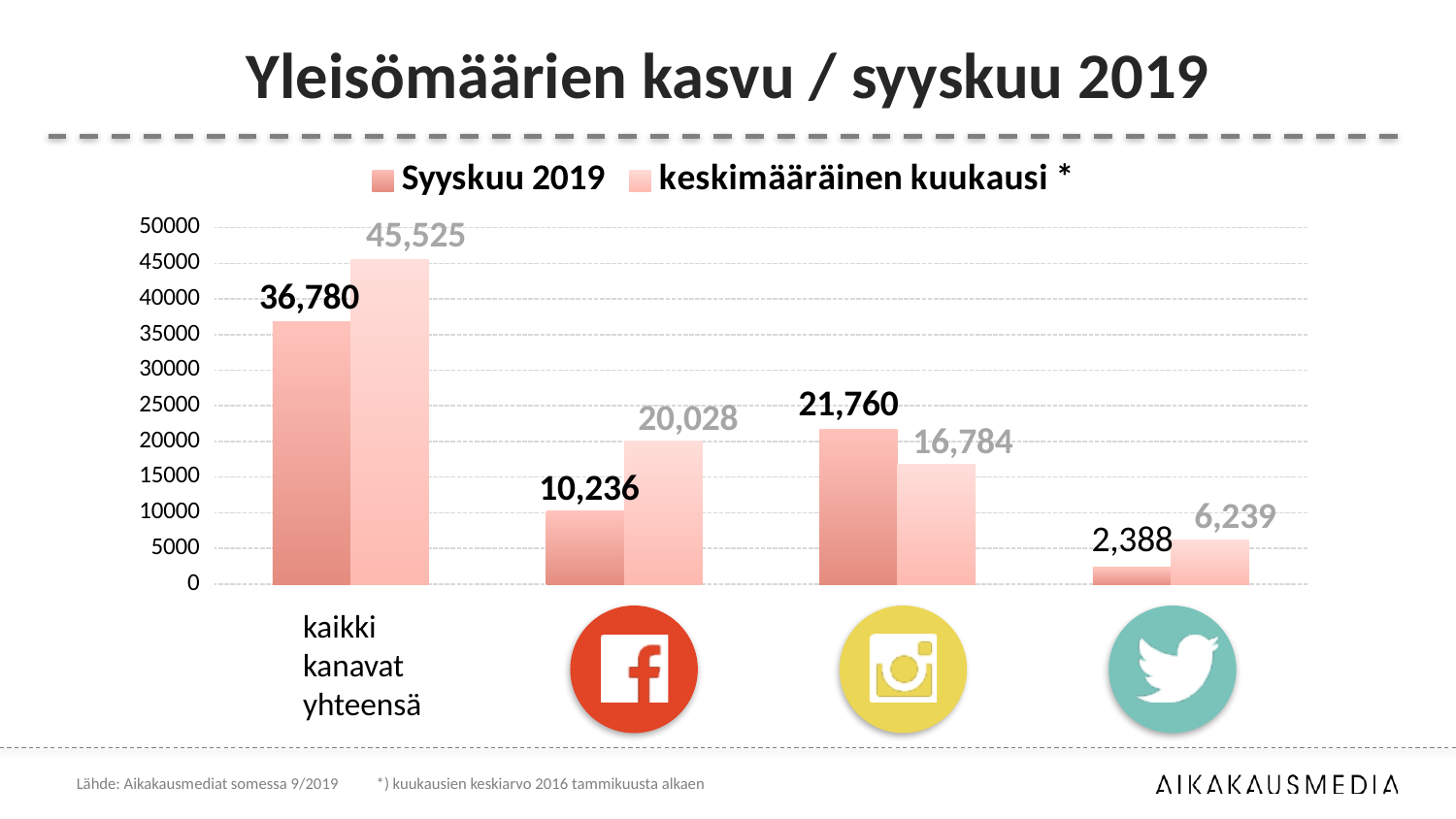
What is the Syyskuu 2019 value for the Facebook category? 10,236 How many categories are shown on the x axis? 4 Which category has the lowest Syyskuu 2019 value? Twitter How many series does the legend list? 2 What is the keskimääräinen kuukausi value for kaikki kanavat yhteensä? 45,525 What is the keskimääräinen kuukausi value for the Instagram category? 16,784 Is the keskimääräinen kuukausi value for the Twitter category greater or less than 5000? greater For the Instagram category, which is larger: the Syyskuu 2019 value or the keskimääräinen kuukausi value? Syyskuu 2019 What is the difference between the keskimääräinen kuukausi and Syyskuu 2019 values for the Facebook category? 9,792 What kind of chart is shown on the slide? Bar chart What is the Syyskuu 2019 value for the Twitter category? 2,388 What is the Syyskuu 2019 value for kaikki kanavat yhteensä? 36,780